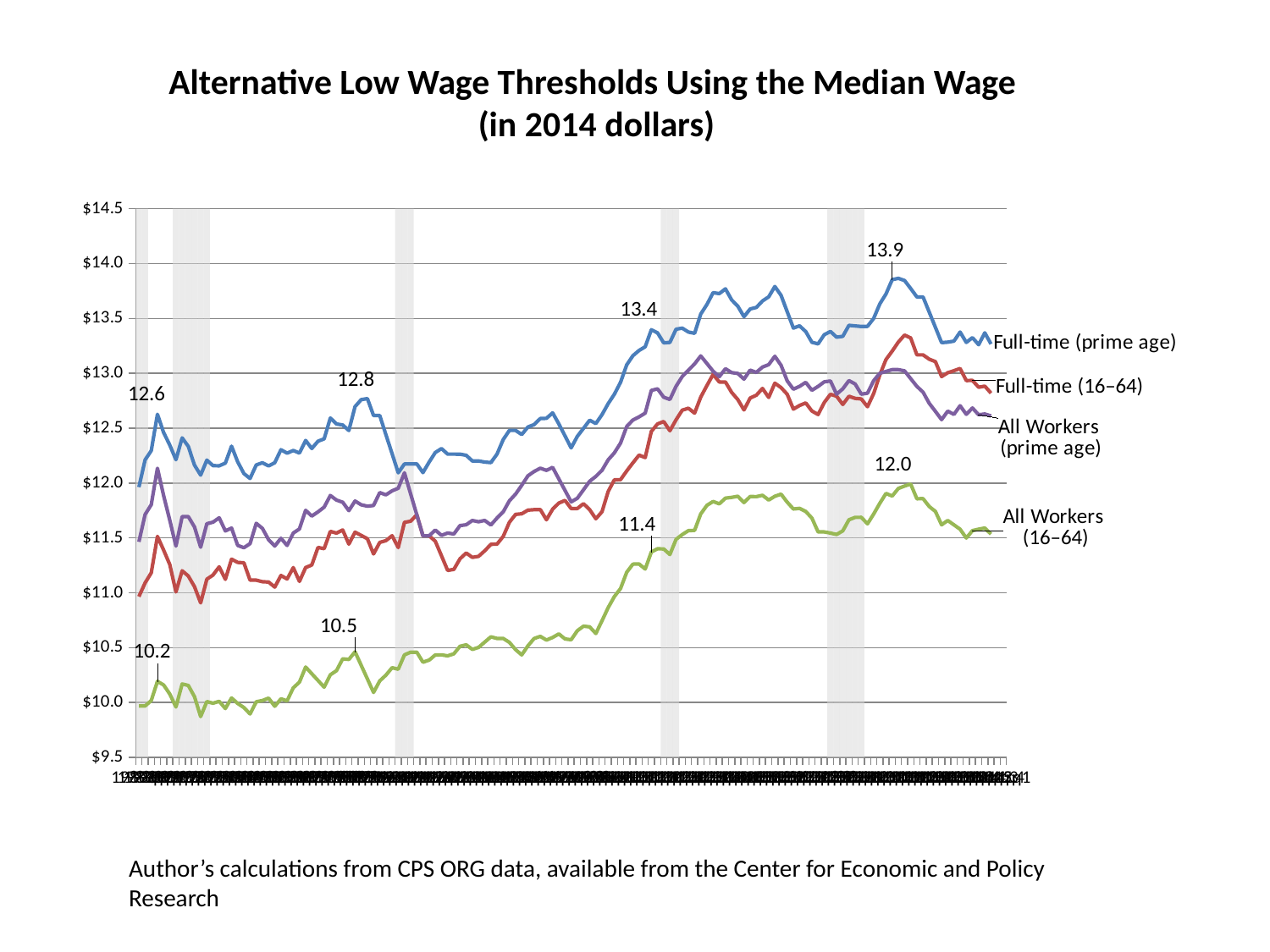
What is the title of the chart? Alternative Low Wage Thresholds Using the Median Wage (in 2014 dollars) Do the values of the Full-time (prime age) line generally rise or fall from left to right? rise What is the highest labelled value on the All Workers (16–64) line? 12.0 How many series are plotted on the chart? 4 Which series has the lowest values across the chart? All Workers (16–64) Is the peak value of the All Workers (16–64) line greater or less than $12.5? less What is the difference between the labelled values 13.9 and 12.6 on the Full-time (prime age) line? 1.3 What is the first labelled value on the All Workers (16–64) line? 10.2 Which series has the highest values across the chart? Full-time (prime age) What kind of chart is shown on the slide? line chart What is the highest labelled value on the Full-time (prime age) line? 13.9 What is the difference between the labelled values 12.0 and 10.2 on the All Workers (16–64) line? 1.8